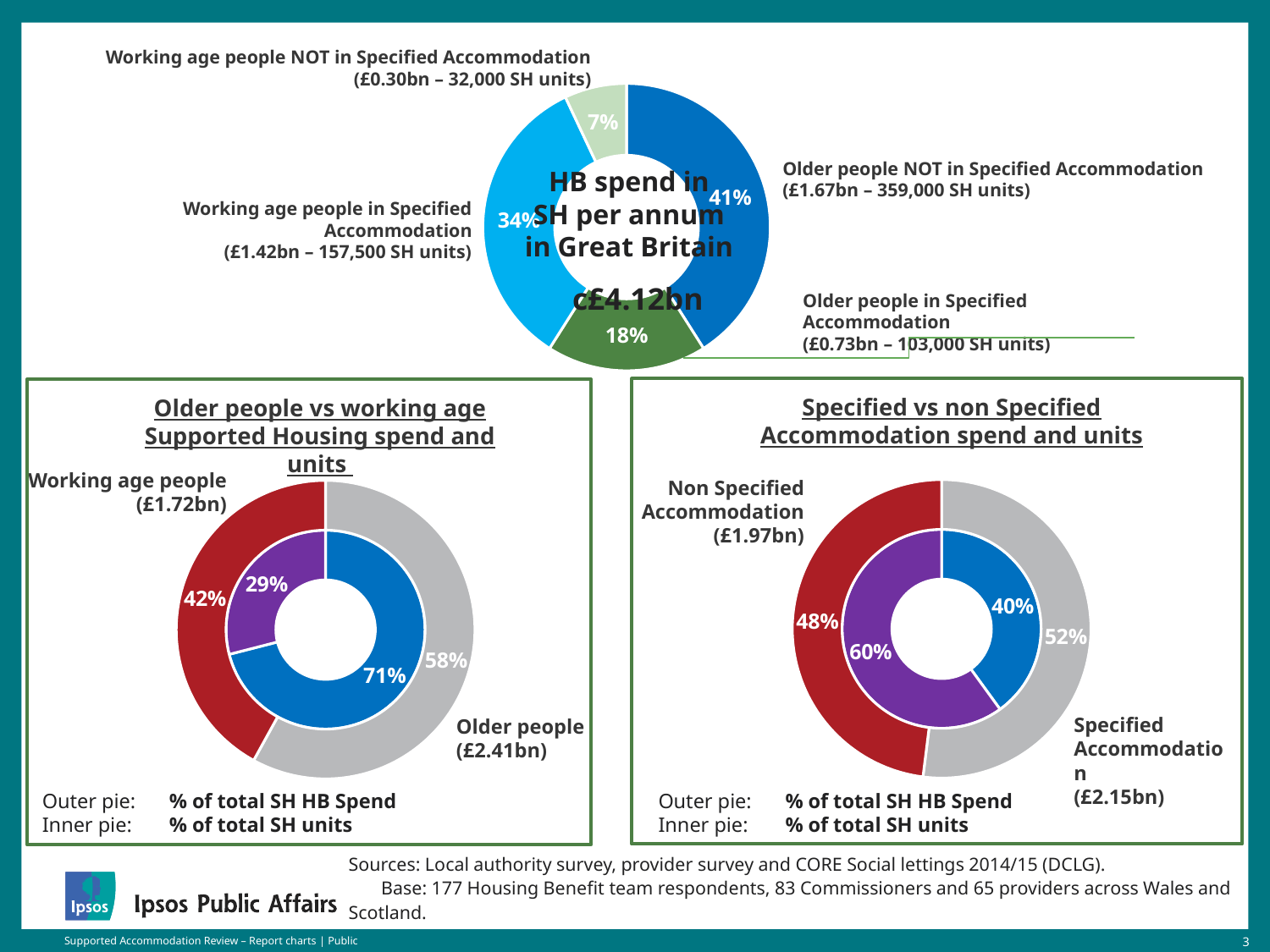
In the top chart 'HB spend in SH per annum in Great Britain', how many categories are shown? 4 In the chart 'Specified vs non Specified Accommodation spend and units', what percentage of total SH units (inner pie) is for Non Specified Accommodation? 60% In the top chart 'HB spend in SH per annum in Great Britain', which category has the smallest share? Working age people NOT in Specified Accommodation In the chart 'Older people vs working age Supported Housing spend and units', what percentage of total SH HB Spend (outer pie) is for Older people? 58% In the chart 'Older people vs working age Supported Housing spend and units', what percentage of total SH units (inner pie) is for Working age people? 29% In the top chart 'HB spend in SH per annum in Great Britain', which category has the largest share? Older people NOT in Specified Accommodation In the top chart 'HB spend in SH per annum in Great Britain', what is the difference in percentage points between Working age people in Specified Accommodation and Older people in Specified Accommodation? 16 percentage points In the top chart 'HB spend in SH per annum in Great Britain', what percentage is shown for Working age people NOT in Specified Accommodation? 7% In the top chart, what total HB spend in SH per annum in Great Britain is shown in the centre of the donut? c£4.12bn In the chart 'Specified vs non Specified Accommodation spend and units', which has the larger share of total SH HB Spend (outer pie): Specified Accommodation or Non Specified Accommodation? Specified Accommodation What type of chart is used in the bottom-right chart 'Specified vs non Specified Accommodation spend and units'? Pie chart (doughnut) In the top chart 'HB spend in SH per annum in Great Britain', what percentage is shown for Older people NOT in Specified Accommodation? 41%